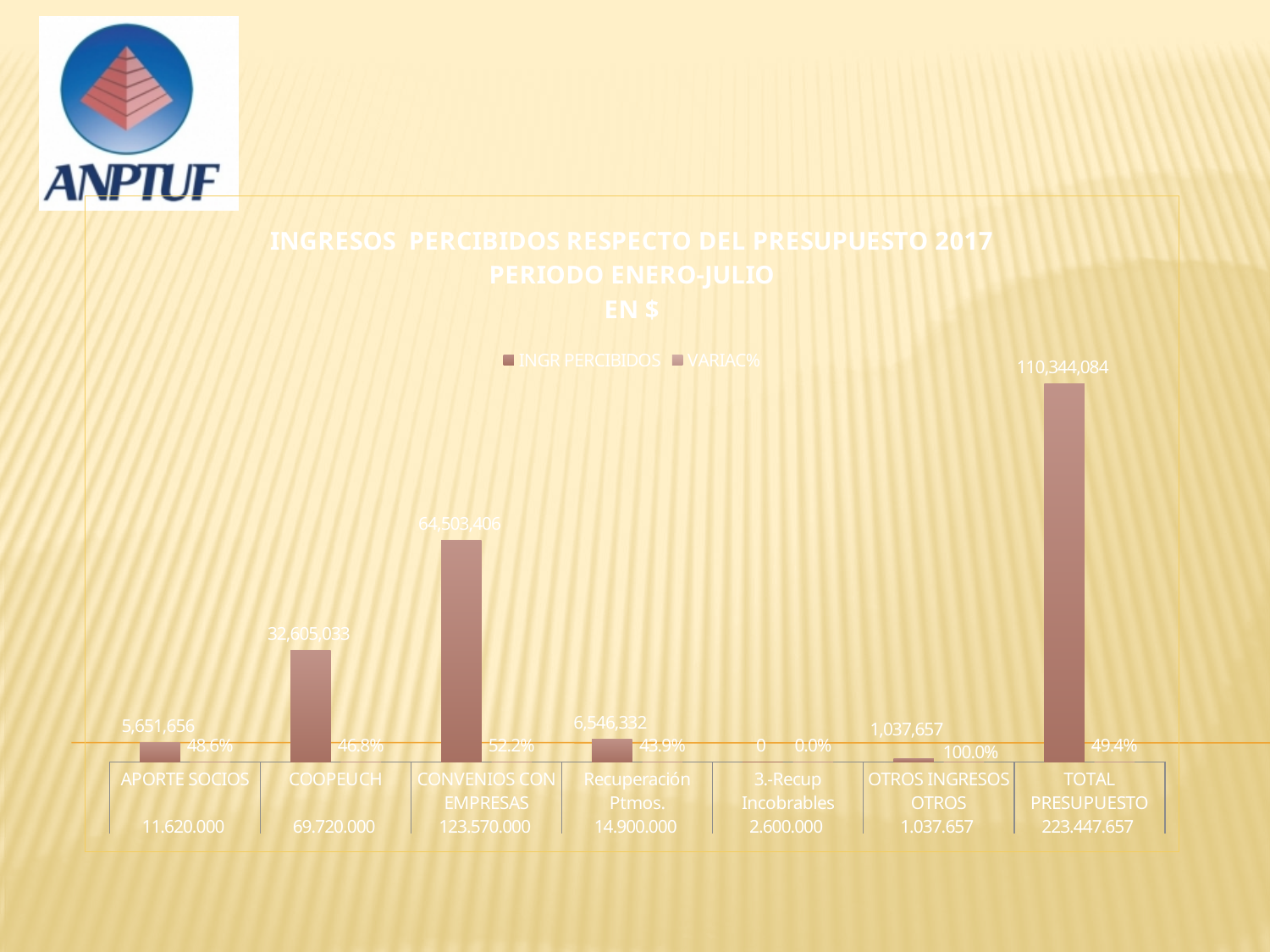
What is the INGR PERCIBIDOS value for COOPEUCH? 32,605,033 What is the INGR PERCIBIDOS value for TOTAL PRESUPUESTO? 110,344,084 Which category has the highest INGR PERCIBIDOS value? TOTAL PRESUPUESTO What kind of chart is shown on the slide? Bar chart What is the INGR PERCIBIDOS value for CONVENIOS CON EMPRESAS? 64,503,406 What is the VARIAC% value for OTROS INGRESOS OTROS? 100.0% How many categories are shown on the x axis of the chart? 7 What is the VARIAC% value for APORTE SOCIOS? 48.6% What is the difference in INGR PERCIBIDOS between CONVENIOS CON EMPRESAS and COOPEUCH? 31,898,373 How many series does the legend list? 2 Which category has the lowest INGR PERCIBIDOS value? 3.-Recup Incobrables Which has a larger INGR PERCIBIDOS value, Recuperación Ptmos. or APORTE SOCIOS? Recuperación Ptmos.